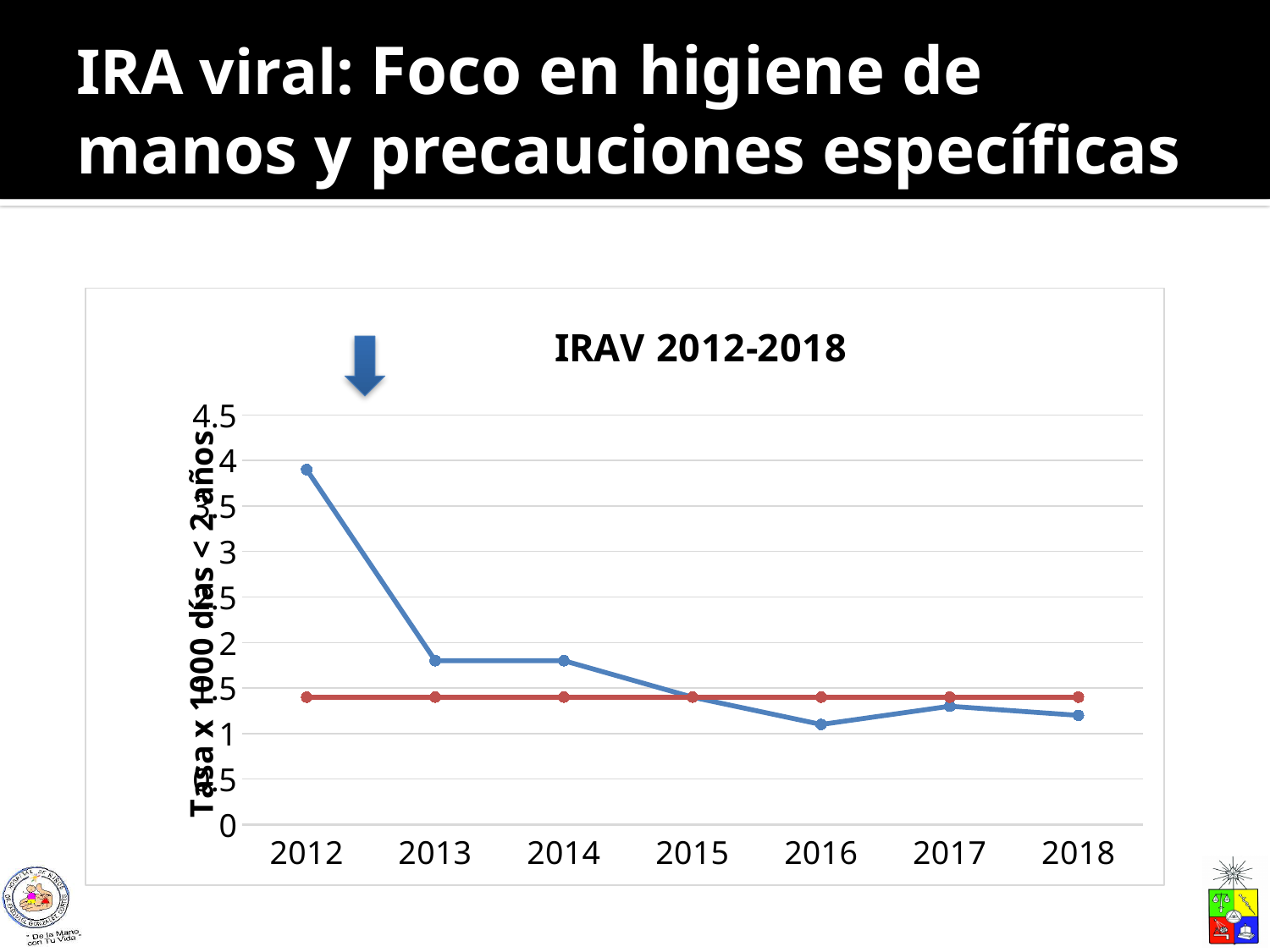
Does the red line rise, fall, or stay flat across the years? stay flat In which year does the blue line reach its highest value? 2012 Does the blue line generally rise or fall from 2012 to 2018? fall Which year has the larger value on the blue line, 2012 or 2013? 2012 What is the label on the vertical axis of the chart? Tasa x 1000 días < 2 años Is the value of the blue line for 2016 greater or less than 1.5? less Is the value of the blue line for 2013 greater or less than 2? less How many years are shown on the x axis of the chart? 7 What is the title of the chart? IRAV 2012-2018 Is the value of the blue line for 2012 greater or less than 3.5? greater Which year has the larger value on the blue line, 2014 or 2016? 2014 What kind of chart is shown on the slide? line chart